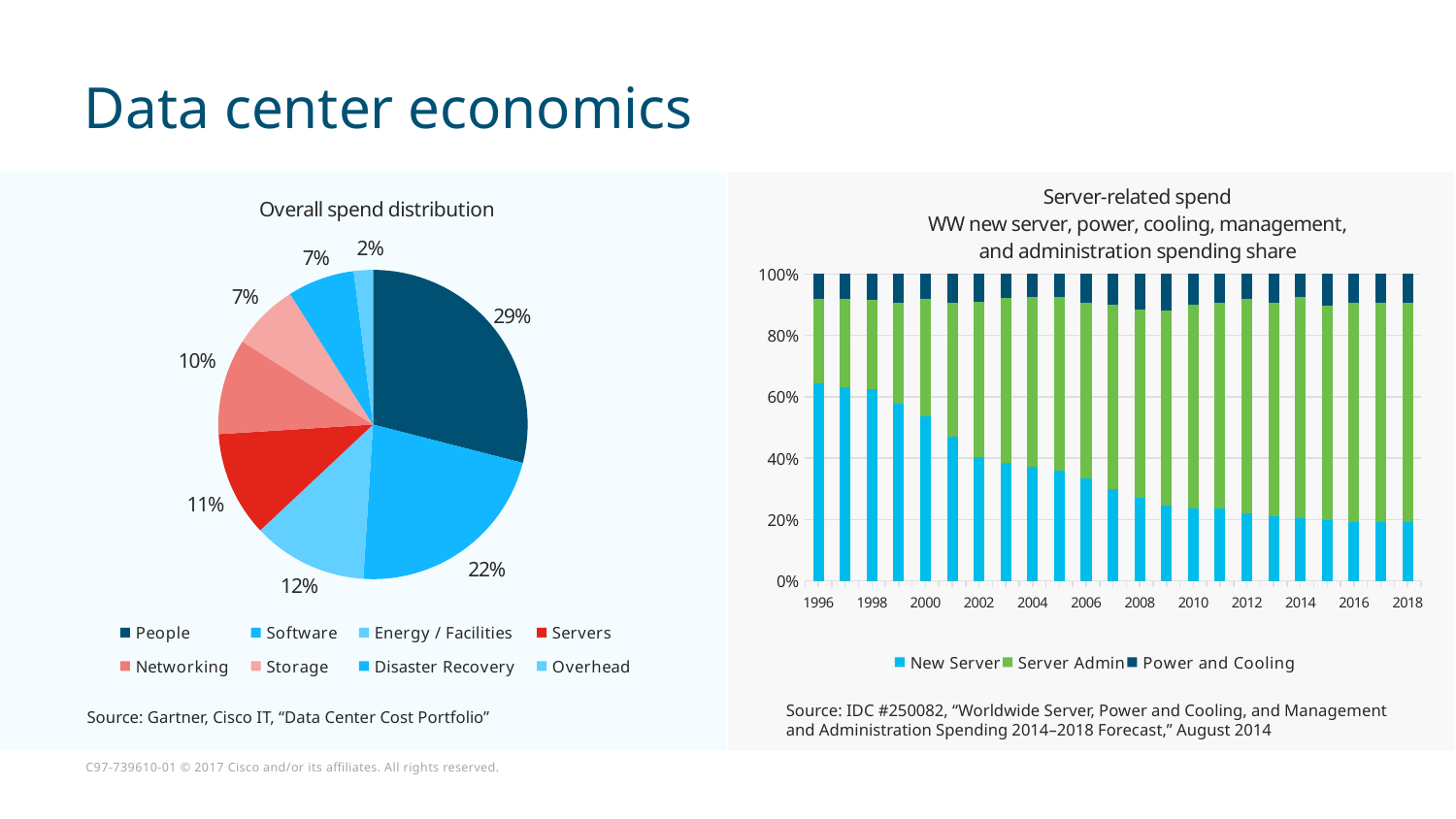
In the Server-related spend chart, is the New Server share for 1996 greater or less than 60%? greater In the Overall spend distribution pie chart, how many percentage points larger is the People share than the Software share? 7 percentage points How many series does the legend of the Server-related spend chart list? 3 In the Server-related spend chart, does the New Server share rise or fall from 1996 to 2018? Fall How many categories does the Overall spend distribution pie chart show? 8 In the Overall spend distribution pie chart, what share is attributed to Energy / Facilities? 12% In the Overall spend distribution pie chart, which category has the smallest share? Overhead In the Overall spend distribution pie chart, what share is attributed to People? 29% In the Overall spend distribution pie chart, which category has the largest share? People What kind of chart is the Overall spend distribution chart on the left? Pie chart In the Overall spend distribution pie chart, which is larger: the Servers share or the Networking share? Servers What kind of chart is the Server-related spend chart on the right? Stacked bar chart